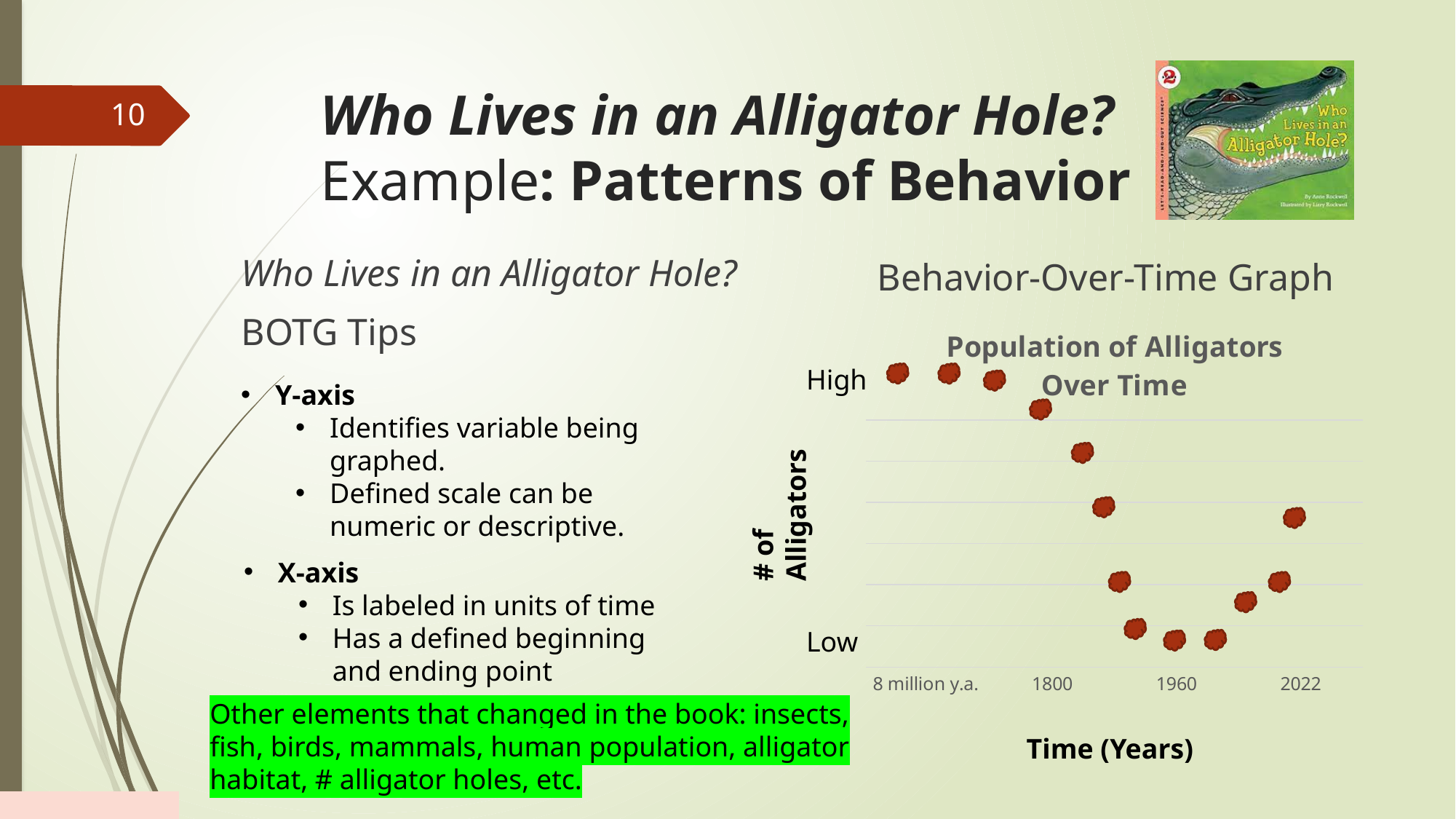
On the Population of Alligators Over Time graph, is the number of alligators higher at 8 million y.a. or at 2022? 8 million y.a. Around which x-axis year does the Population of Alligators Over Time graph reach its lowest point? 1960 On the Population of Alligators Over Time graph, is the number of alligators higher at 1800 or at 1960? 1800 What is the first (leftmost) label on the x-axis of the Population of Alligators Over Time graph? 8 million y.a. How many labelled tick marks are shown on the x-axis of the Population of Alligators Over Time graph? 4 What is the label of the x-axis on the Population of Alligators Over Time graph? Time (Years) What is the last (rightmost) label on the x-axis of the Population of Alligators Over Time graph? 2022 What are the two descriptive scale labels on the y-axis of the Population of Alligators Over Time graph? High and Low What is the title of the graph on the right side of the slide? Population of Alligators Over Time On the Population of Alligators Over Time graph, does the number of alligators rise or fall between 8 million y.a. and 1960? fall On the Population of Alligators Over Time graph, does the number of alligators rise or fall between 1960 and 2022? rise What kind of chart is the Population of Alligators Over Time graph? scatter (dot) plot